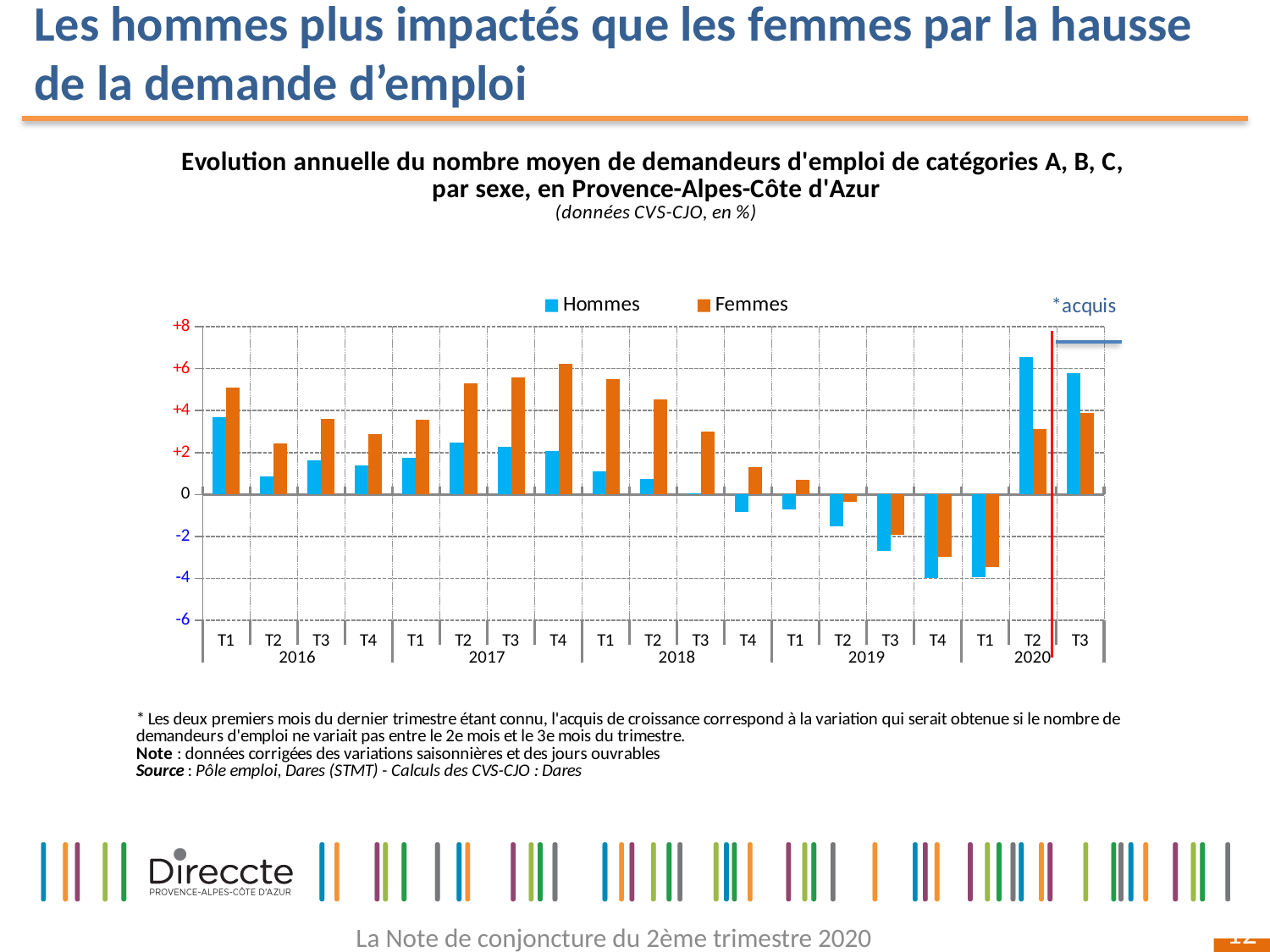
Is the Femmes value for T1 2016 greater or less than +4? greater In which quarter is the Femmes value highest? T4 2017 Is the Hommes value for T2 2020 greater or less than +6? greater What kind of chart is shown on the slide? bar chart Is the Hommes value for T4 2019 greater or less than -2? less In which quarter is the Hommes value highest? T2 2020 How many series does the legend list? 2 Do the Hommes values rise or fall from T1 2018 to T4 2019? fall How many quarters are plotted along the x axis? 19 In T1 2016, which is larger, the Hommes value or the Femmes value? Femmes Which series is shown in blue? Hommes